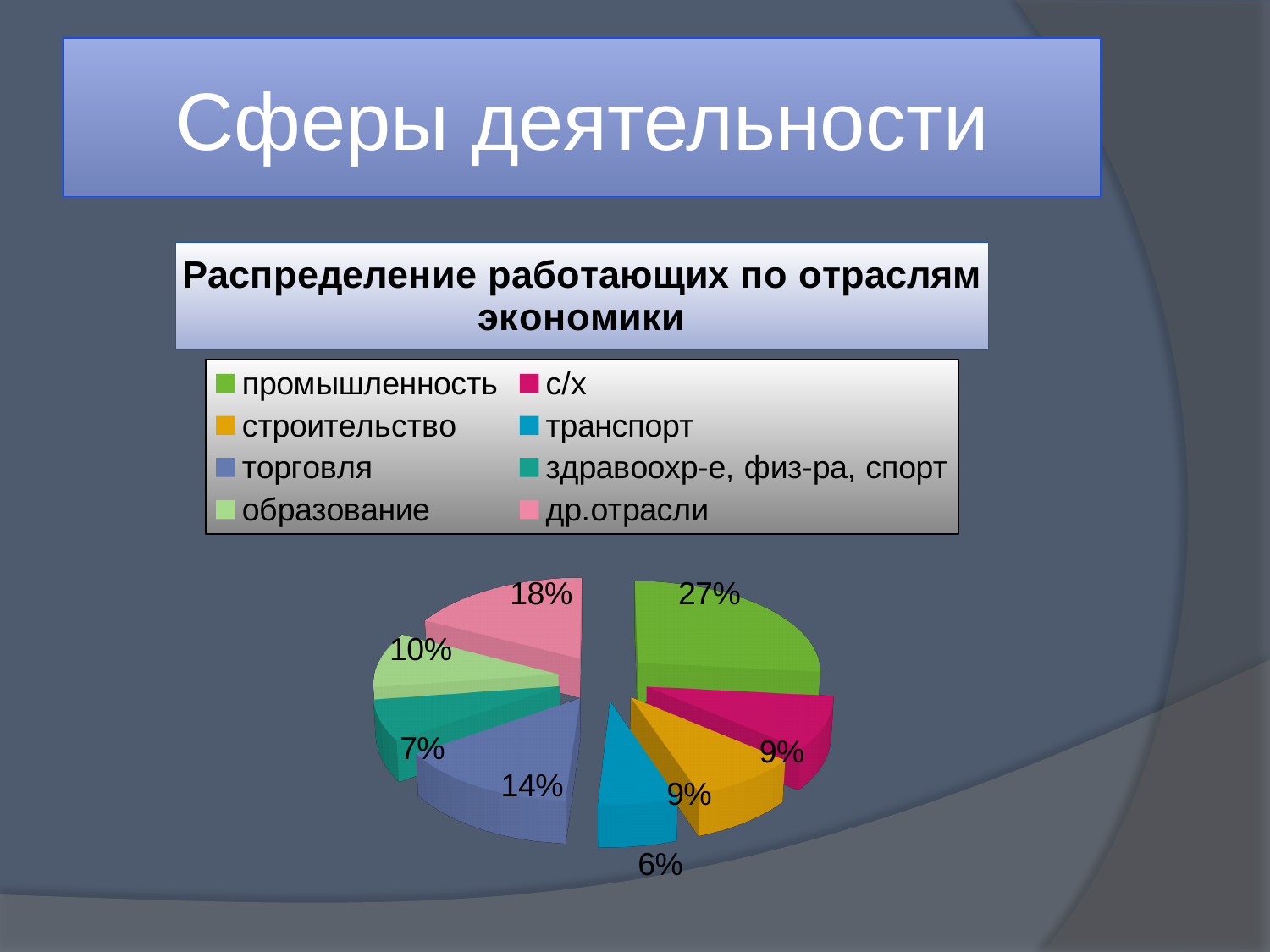
What share of the pie does торговля have? 14% How many categories does the legend of the pie chart list? 8 Which category has the smallest share of the pie? транспорт What share of the pie does образование have? 10% Which category has the largest share of the pie? промышленность What share of the pie does транспорт have? 6% What type of chart is shown on the slide? pie chart What is the difference between the shares of промышленность and др.отрасли? 9% What is the title of the chart? Распределение работающих по отраслям экономики Which has a larger share, торговля or образование? торговля